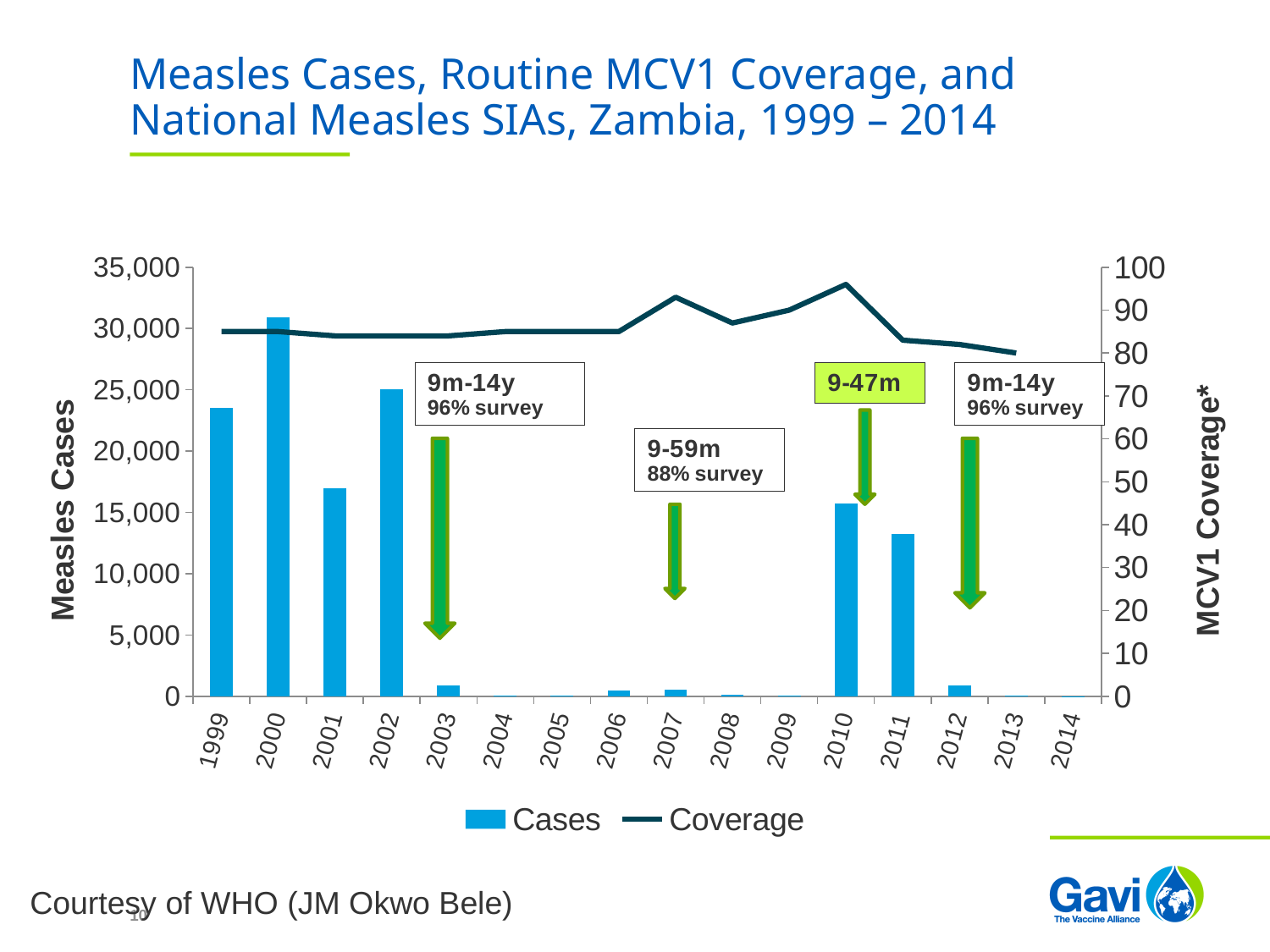
Which year has the highest number of measles cases? 2000 Is the number of measles cases in 2011 greater or less than 15,000? less Is the MCV1 coverage in 2010 greater or less than 90? greater Is the number of measles cases in 2000 greater or less than 30,000? greater Which year has more measles cases, 2002 or 2001? 2002 How many series does the legend list? 2 What are the two series named in the legend? Cases and Coverage How many years are shown on the x axis? 16 Does the MCV1 coverage line rise or fall from 2010 to 2013? Fall What kind of chart is shown on the slide? A combined bar and line chart